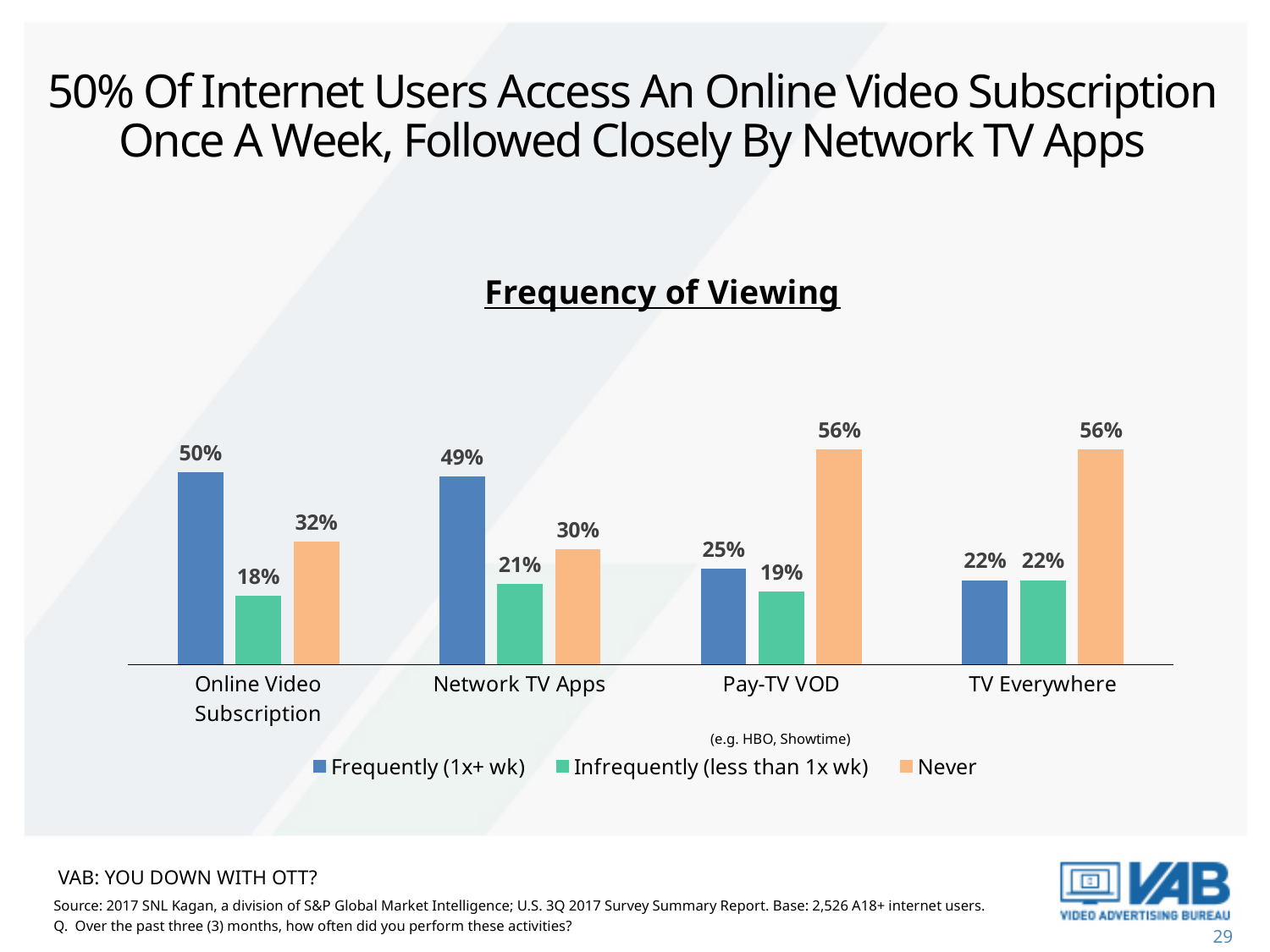
What is the value for Infrequently (less than 1x wk) for Network TV Apps? 21% What is the title of the chart? Frequency of Viewing How many series does the legend list? 3 What is the difference between the Never values for Online Video Subscription and Network TV Apps? 2% Which category has the lowest value for Infrequently (less than 1x wk)? Online Video Subscription Which is larger for Pay-TV VOD: Frequently (1x+ wk) or Never? Never What is the difference between the Frequently (1x+ wk) and Infrequently (less than 1x wk) values for TV Everywhere? 0% Which category has the highest value for Frequently (1x+ wk)? Online Video Subscription What kind of chart is shown? Bar chart How many categories are shown on the x axis? 4 What is the value for Frequently (1x+ wk) for Online Video Subscription? 50% What is the value for Never for Pay-TV VOD? 56%